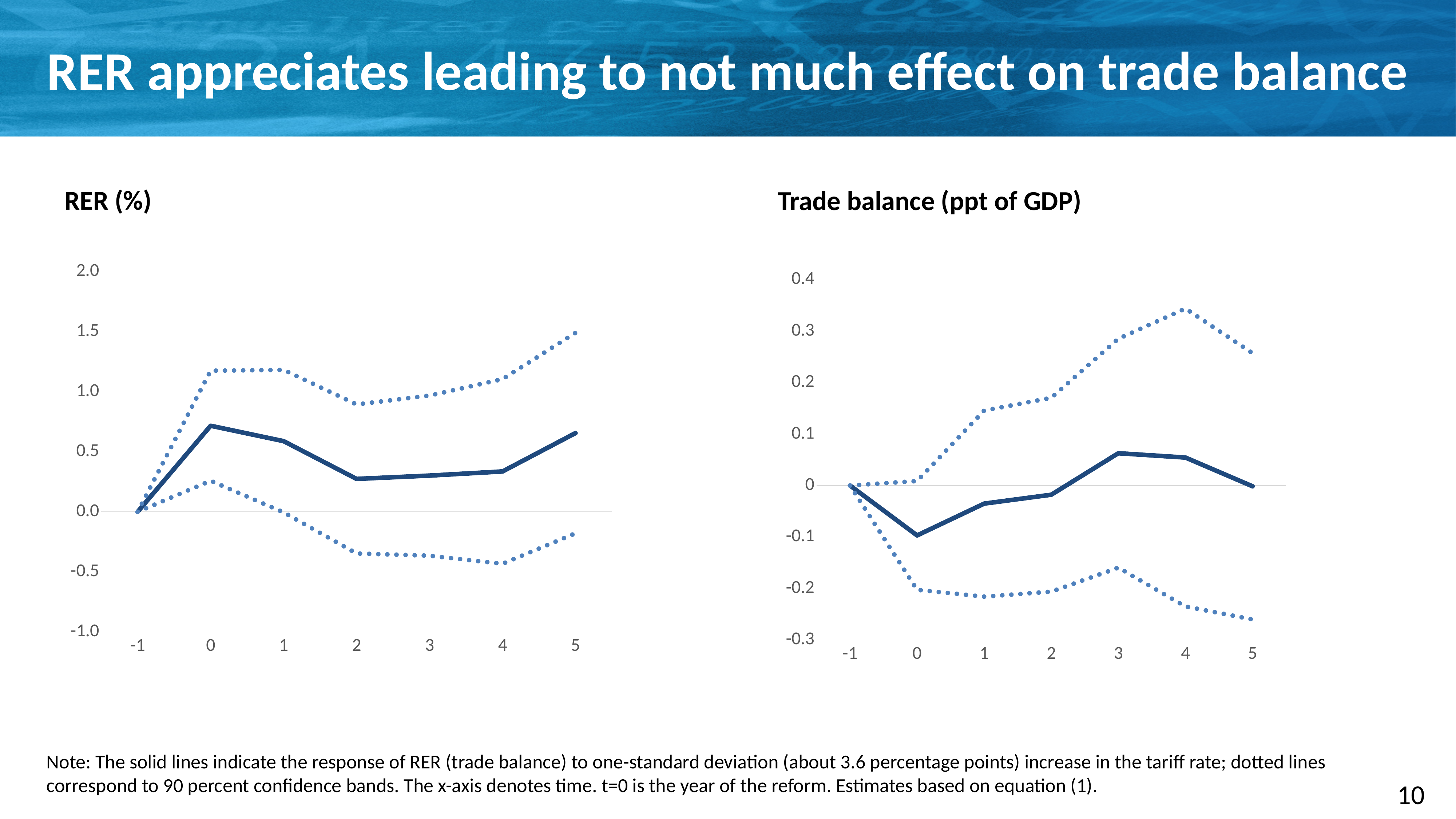
What kind of chart is the RER (%) chart? line chart According to the note on the slide, what do the dotted lines in the charts represent? 90 percent confidence bands In the Trade balance (ppt of GDP) chart, at which time point does the solid line reach its lowest value? 0 In the Trade balance (ppt of GDP) chart, is the solid line's value at t=3 greater or less than 0? greater In the RER (%) chart, at which time point does the solid line reach its highest value? 0 In the RER (%) chart, is the solid line's value at t=2 greater or less than 0.5? less In the RER (%) chart, is the solid line's value at t=0 greater or less than 0.5? greater In the Trade balance (ppt of GDP) chart, how many time points are shown on the x-axis? 7 In the RER (%) chart, what is the value of the solid line at t=-1? 0.0 In the RER (%) chart, is the solid line's value larger at t=0 or at t=2? t=0